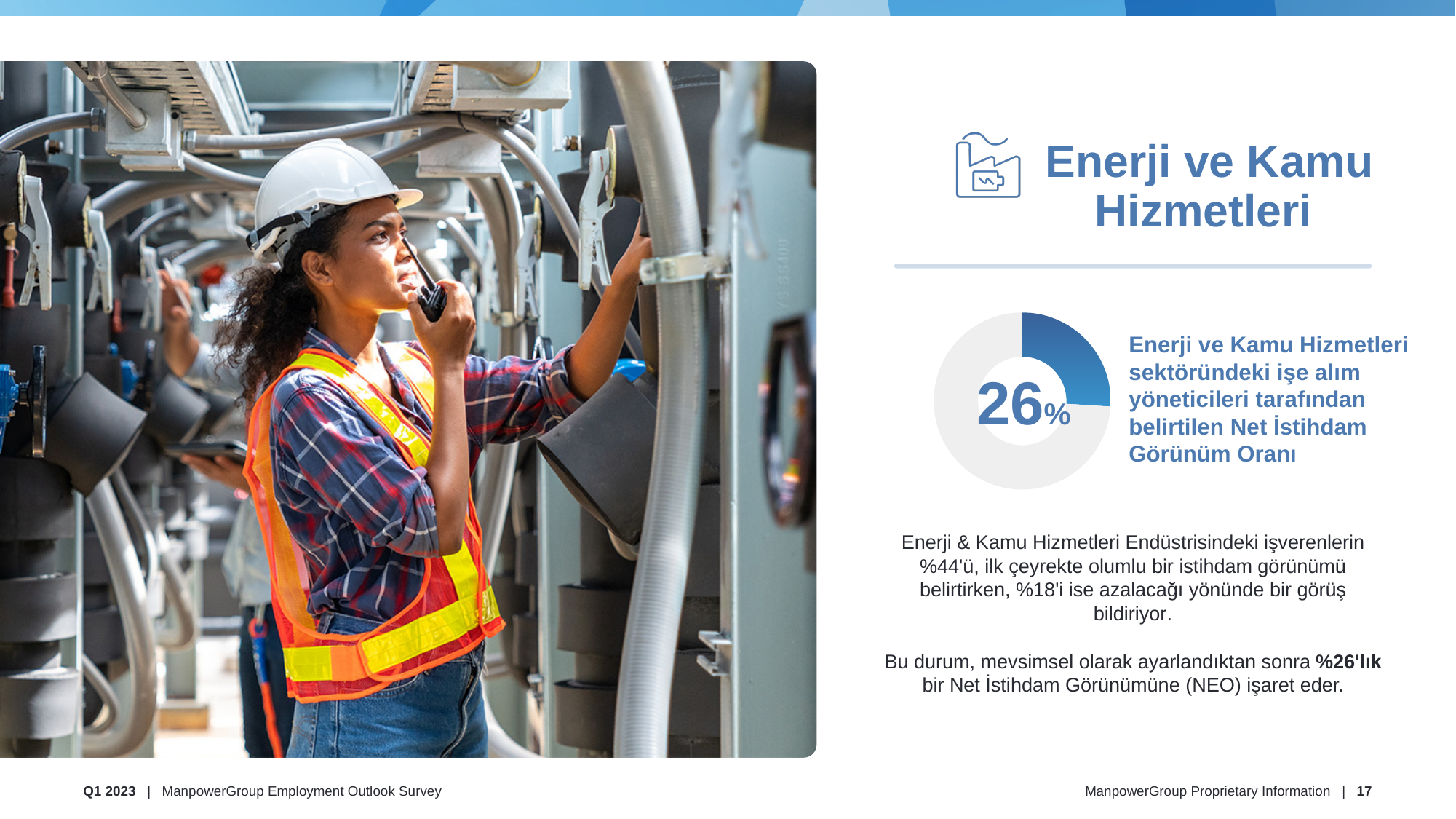
What value is printed in the centre of the donut chart? 26% How many distinct segments does the donut chart have? 2 What kind of chart is shown on the slide next to the text about Net İstihdam Görünüm Oranı? Donut (pie) chart Is the value shown in the donut chart greater or less than 50%? less What share of the donut chart is filled by the blue segment? 26% What is the title of the section that the donut chart belongs to? Enerji ve Kamu Hizmetleri What colour is the segment of the donut chart that represents the 26% value? Blue What is the Net İstihdam Görünüm Oranı for the Enerji ve Kamu Hizmetleri sector shown in the donut chart? 26%